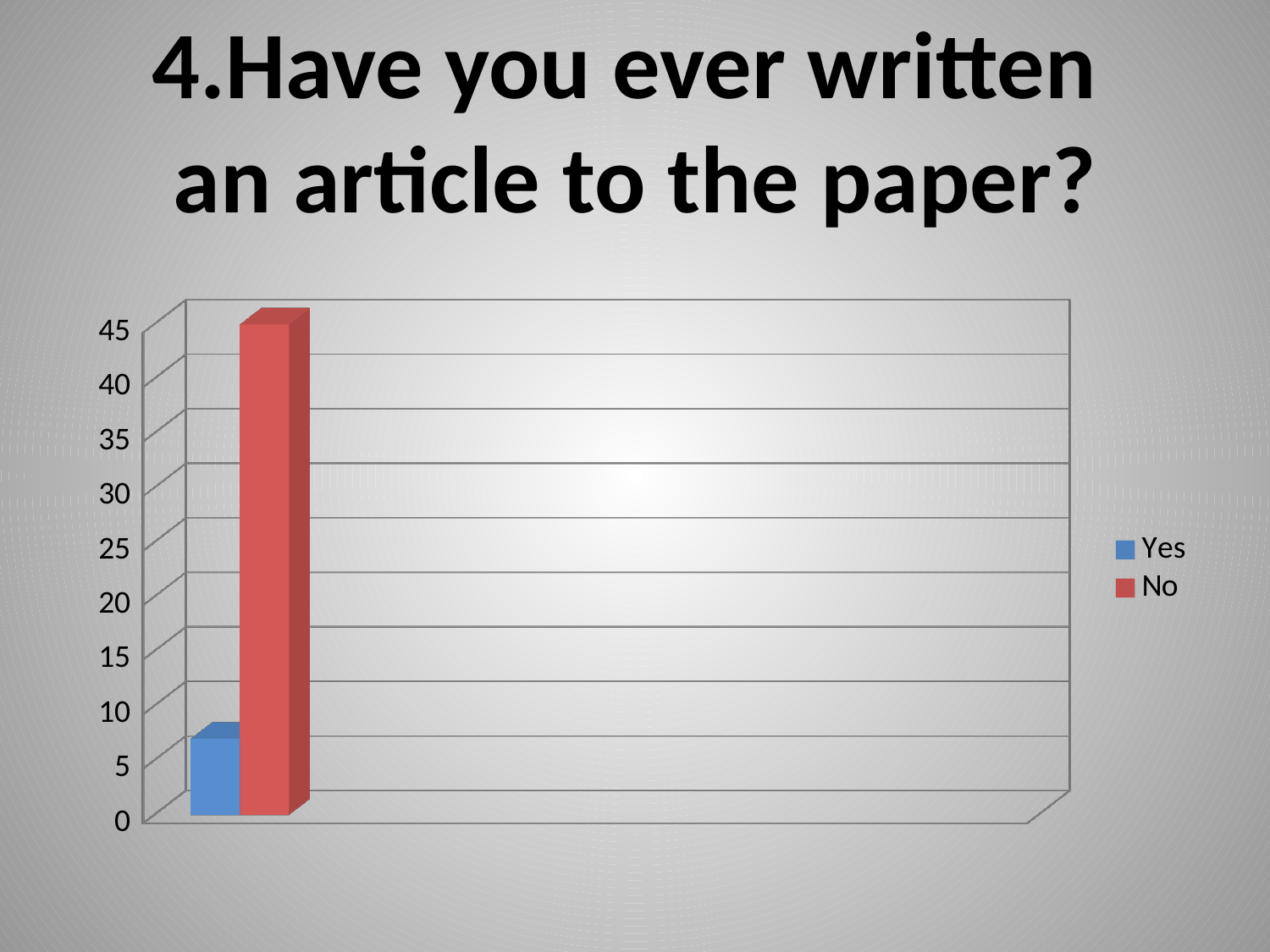
How many series does the legend list? 2 Is the value for No greater or less than 40? greater What colour is the bar for the No series? red Is the value for Yes greater or less than 5? greater What kind of chart is shown on the slide? bar chart Is the bar for Yes larger or smaller than the bar for No? smaller Is the value for No greater or less than 30? greater Which series has the highest bar, Yes or No? No What is the title of the slide above the chart? 4.Have you ever written an article to the paper? Which series has the lowest bar, Yes or No? Yes What is the highest value shown on the vertical axis? 45